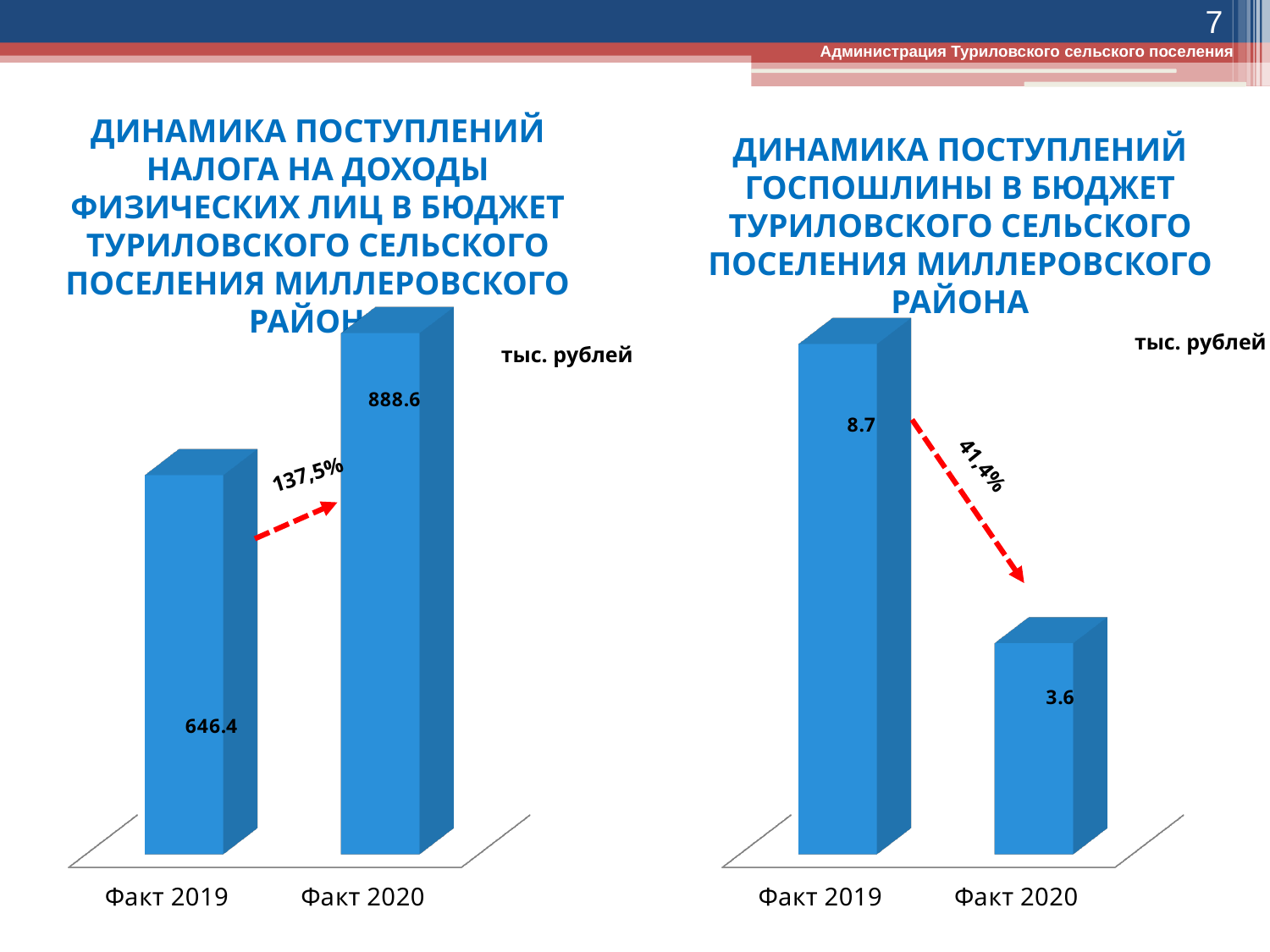
In the left chart (personal income tax receipts), what is the value for Факт 2019? 646.4 How many categories are shown in the right chart? 2 In the left chart, do the values rise or fall from Факт 2019 to Факт 2020? rise In the right chart (state duty receipts), what is the value for Факт 2020? 3.6 What type of chart is the left chart? bar chart In the right chart, what is the difference between the Факт 2019 and Факт 2020 values? 5.1 In the right chart (state duty receipts), what is the value for Факт 2019? 8.7 In the left chart, what is the difference between the Факт 2020 and Факт 2019 values? 242.2 In the left chart (personal income tax receipts), what is the value for Факт 2020? 888.6 In the left chart, which category has the higher value? Факт 2020 In the right chart, do the values rise or fall from Факт 2019 to Факт 2020? fall In the right chart, which category has the lower value? Факт 2020